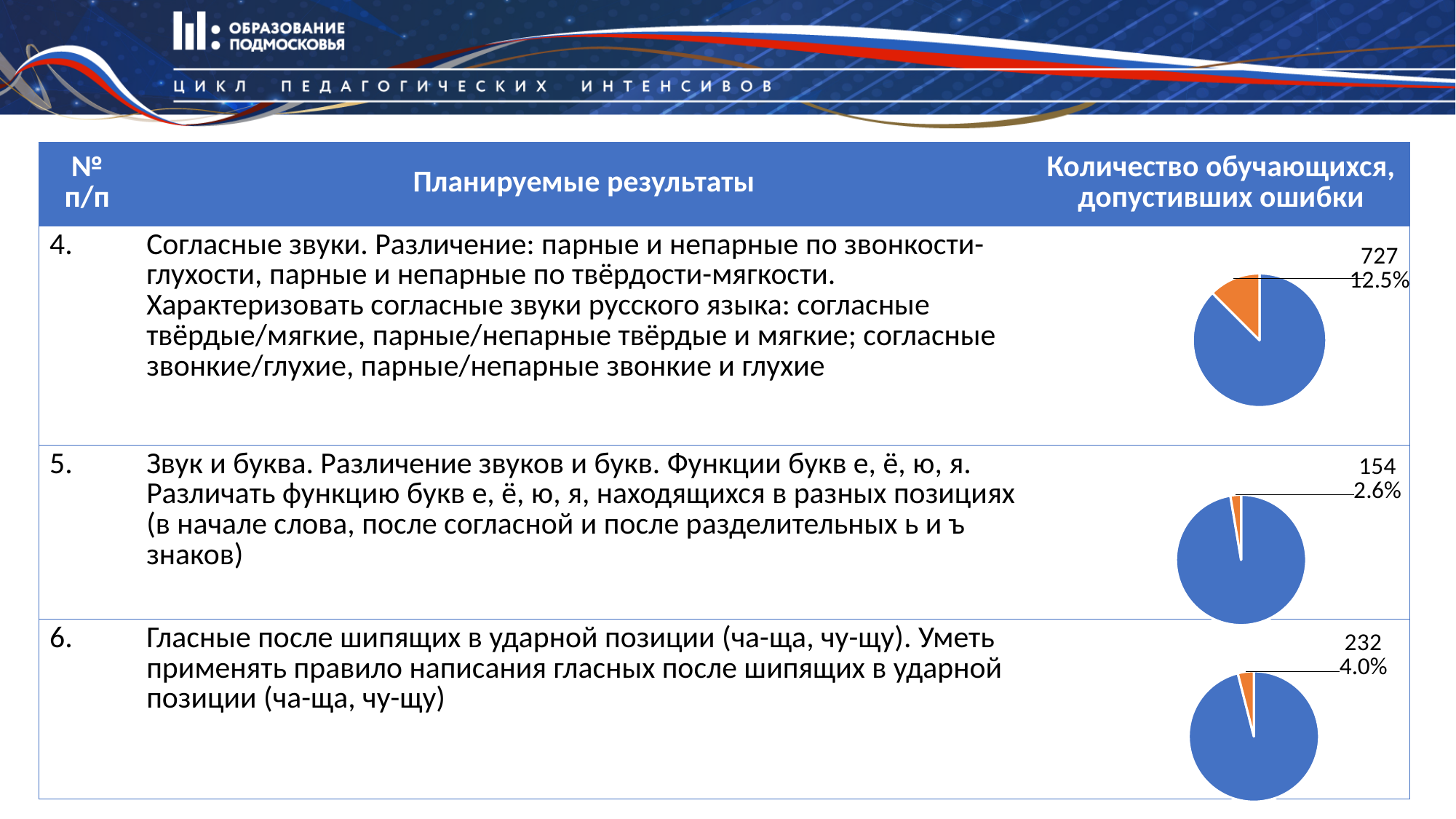
In the pie chart for row 6, what number is printed on the label of the orange slice? 232 Is the labelled value in the row 6 pie chart larger or smaller than the labelled value in the row 5 pie chart? larger In the pie chart for row 5, what percentage is printed for the orange slice? 2.6% Which row's pie chart has the smallest orange slice: row 4, row 5 or row 6? row 5 In the pie chart for row 6, what percentage is printed for the orange slice? 4.0% How many slices does the pie chart in row 6 have? 2 What kind of chart is shown in row 4 of the table? pie chart In the pie chart for row 5, what number is printed on the label of the orange slice? 154 In the pie chart for row 4, what number is printed on the label of the orange slice? 727 In the pie chart for row 4, what percentage is printed for the orange slice? 12.5% Which row's pie chart has the largest orange slice: row 4, row 5 or row 6? row 4 What is the difference between the labelled value in the row 4 pie chart (727) and the labelled value in the row 5 pie chart (154)? 573